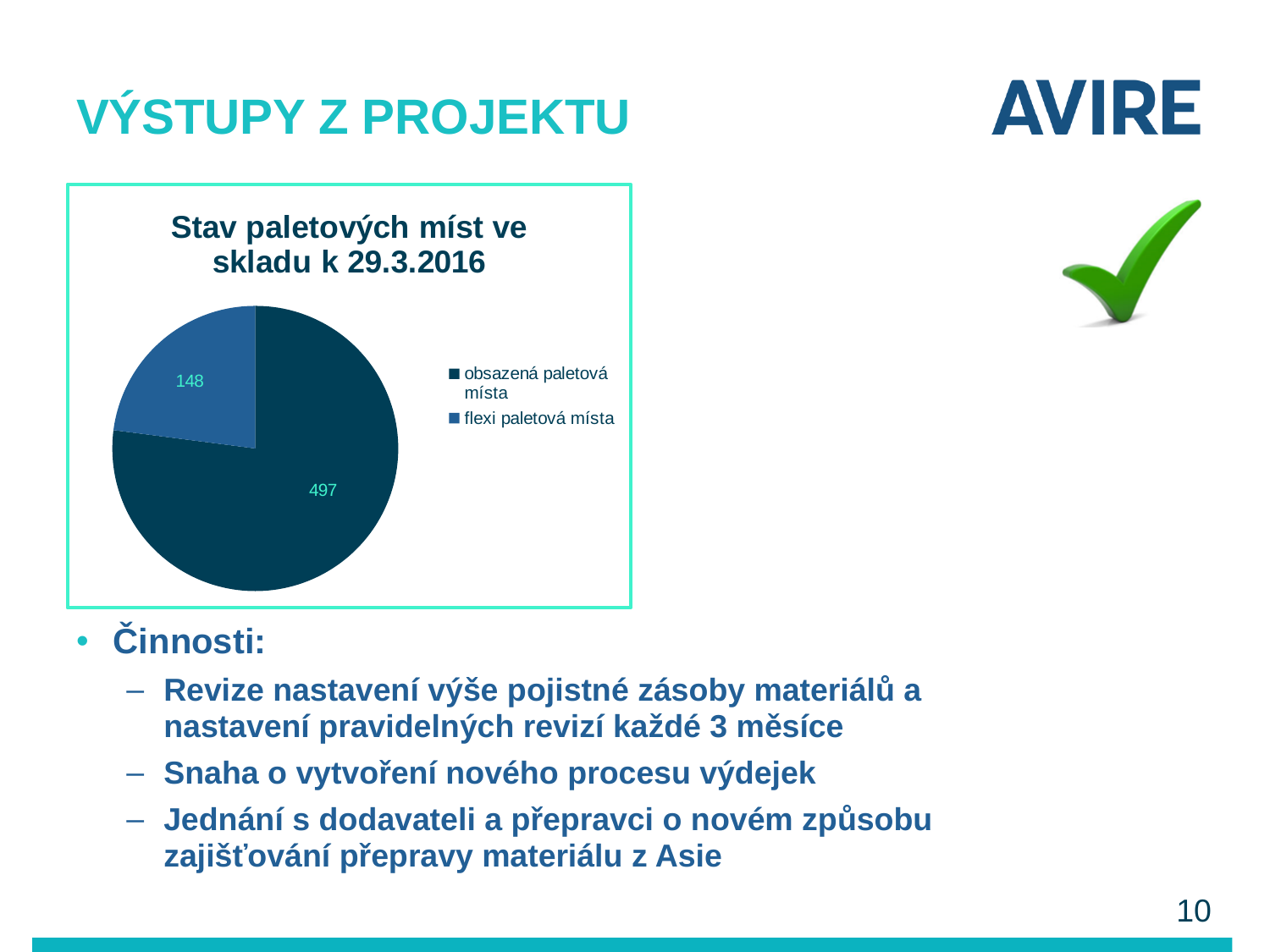
What is the value for flexi paletová místa? 148 What is the difference between obsazená paletová místa and flexi paletová místa? 349 Which category has the smallest slice of the pie? flexi paletová místa What kind of chart is shown on the slide? pie chart Which is larger, obsazená paletová místa or flexi paletová místa? obsazená paletová místa How many entries does the legend list? 2 Which category has the largest slice of the pie? obsazená paletová místa What is the value for obsazená paletová místa? 497 How many slices does the pie chart have? 2 What is the title of the chart? Stav paletových míst ve skladu k 29.3.2016 What is the total of all slices in the pie chart? 645